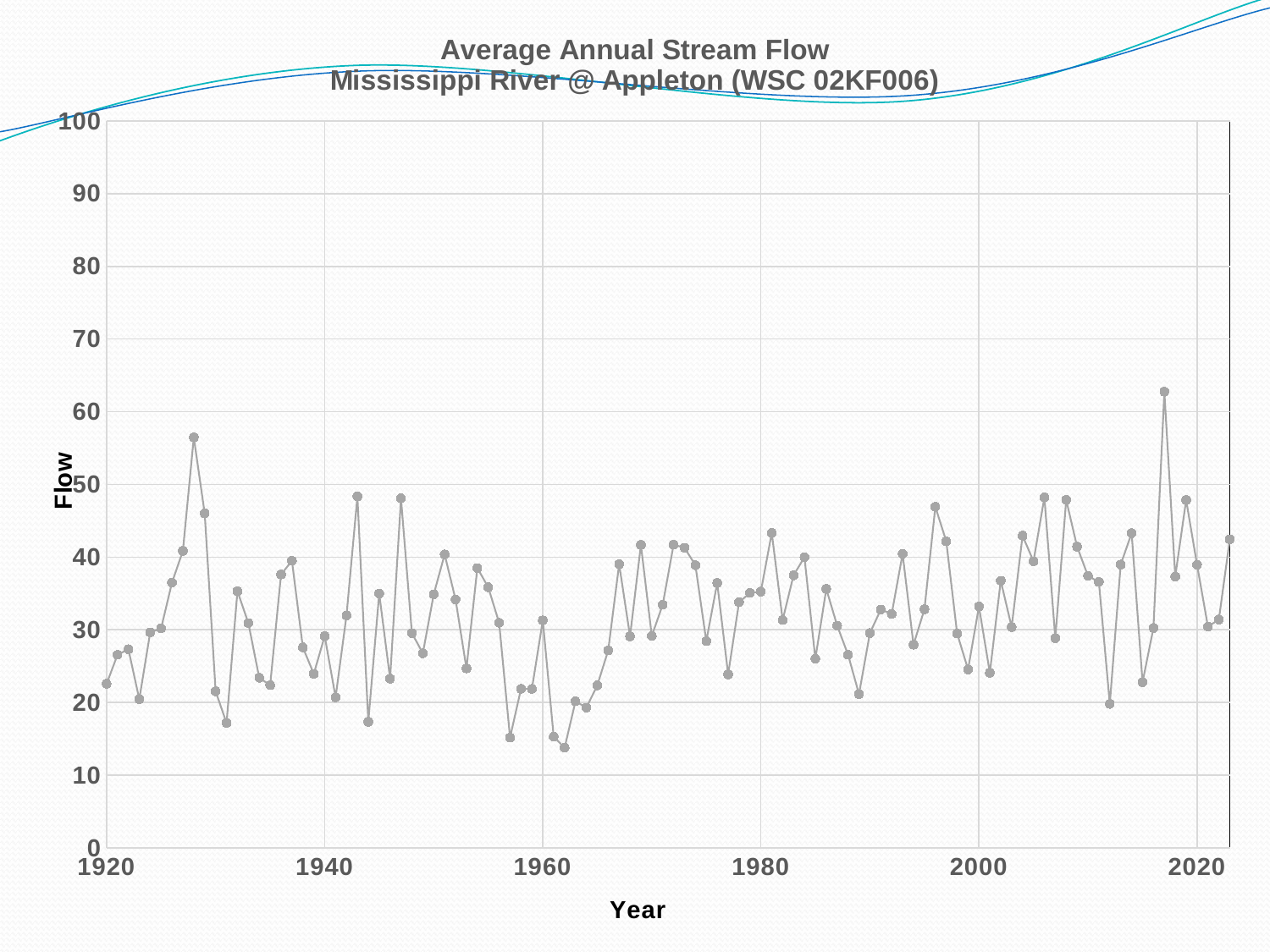
Which year has the larger flow value, 1928 or 2017? 2017 What is the title of the chart? Average Annual Stream Flow Mississippi River @ Appleton (WSC 02KF006) What is the label of the y axis? Flow Is the value for 1996 greater or less than 40? greater What kind of chart is shown on the slide? line chart Is the value for 1928 greater or less than 50? greater In which year does the stream flow reach its highest value? 2017 Is the value for 2017 greater or less than 60? greater Do the flow values rise or fall from 1926 to 1928? rise